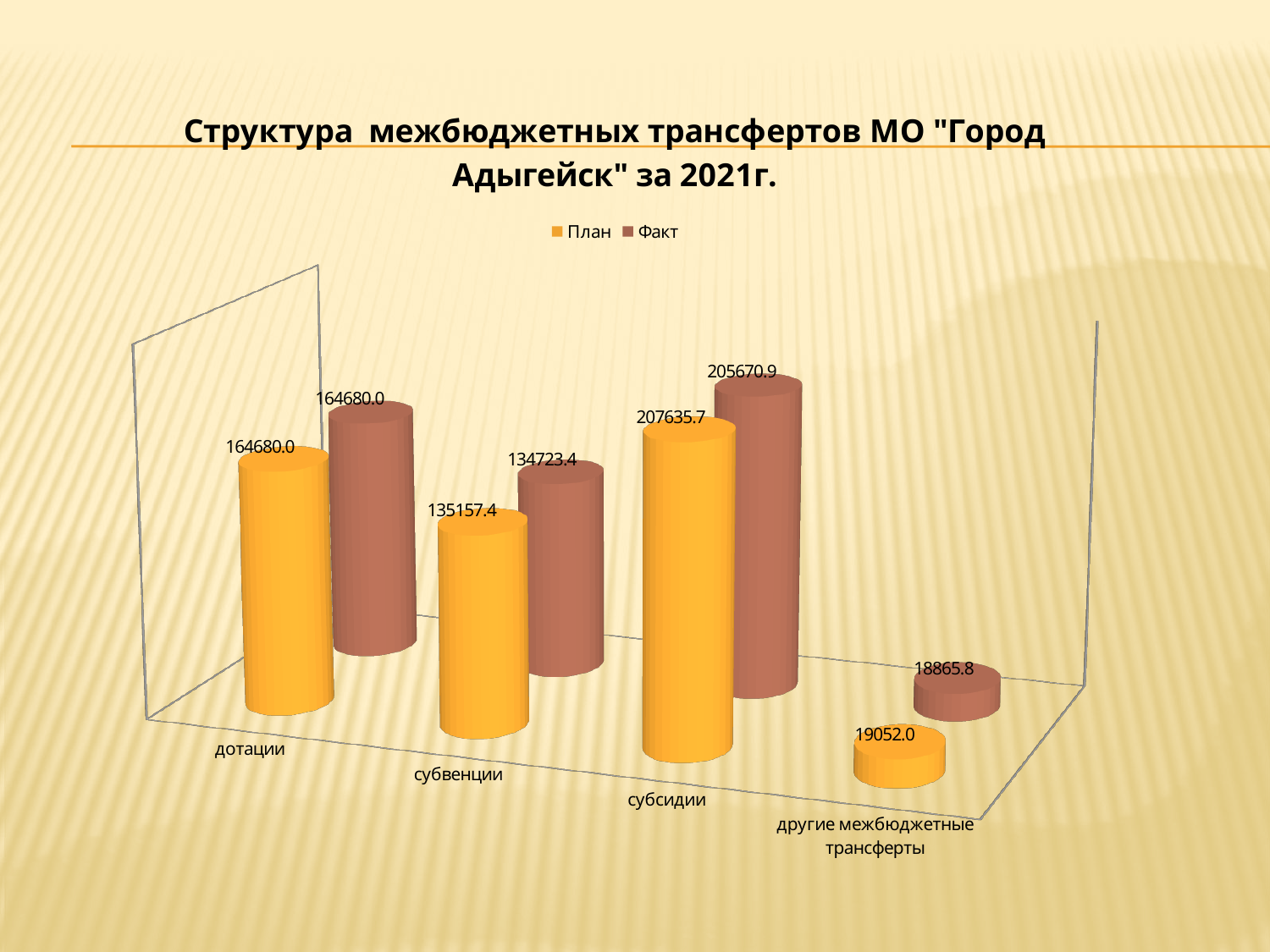
Which category has the highest План value? субсидии What is the difference between the План and Факт values for субвенции? 434.0 What kind of chart is shown on the slide? bar chart Which is larger: the Факт value for субсидии or the Факт value for дотации? субсидии What is the difference between the План and Факт values for субсидии? 1964.8 Which category has the lowest Факт value? другие межбюджетные трансферты What is the План value for субсидии? 207635.7 What is the Факт value for другие межбюджетные трансферты? 18865.8 How many categories are shown on the x axis? 4 What is the План value for дотации? 164680.0 What is the Факт value for субвенции? 134723.4 How many series does the legend list? 2